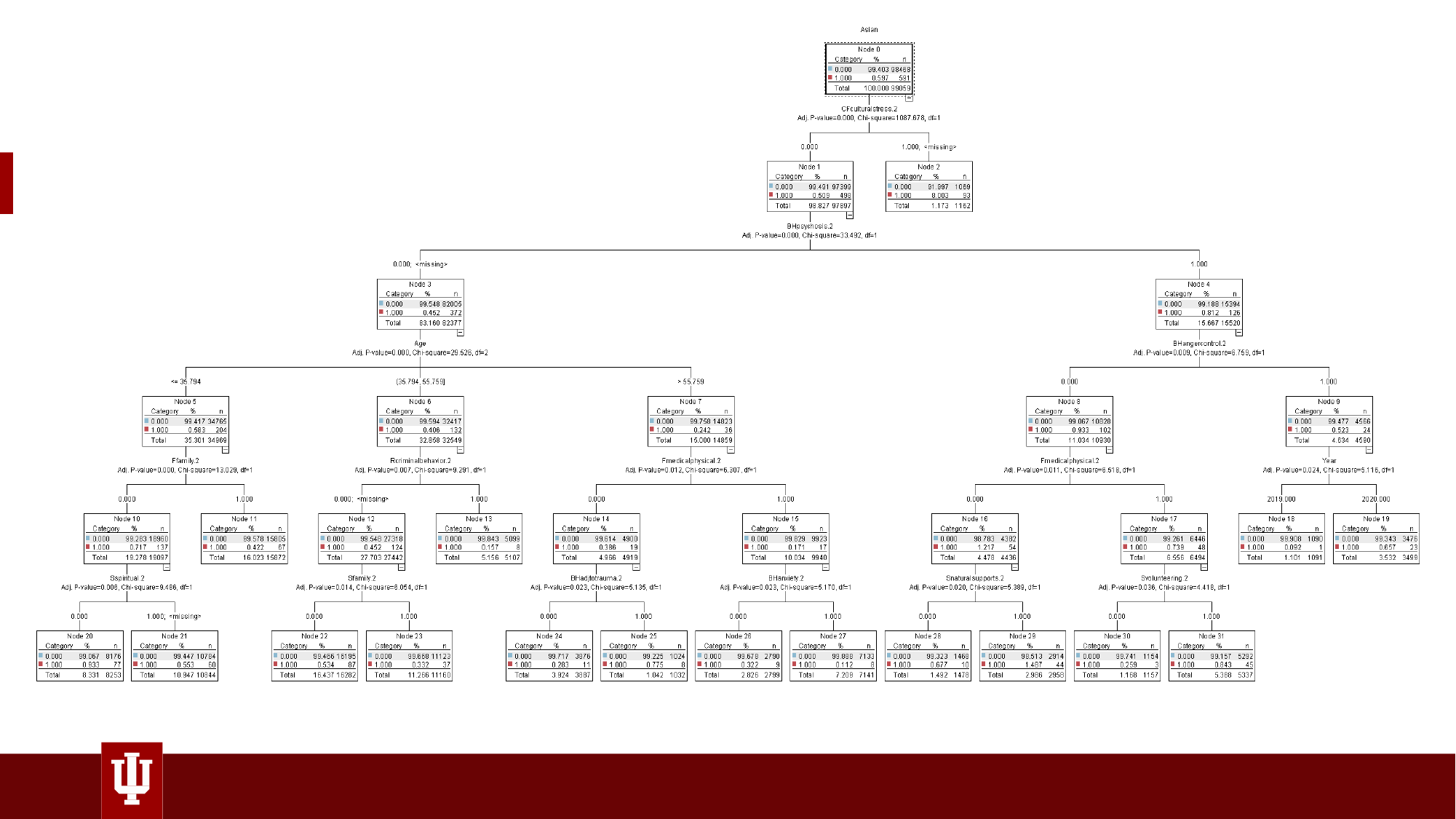
What is the total percentage shown in Node 3? 83.160 Which variable is used for the first split below Node 0? CFculturalstress.2 What percentage of Node 0 falls in category 0.000? 99.403 What is the title printed at the top of the tree? Asian What is the total n shown in Node 2? 1162 What kind of diagram is shown on the slide? decision tree What is the n for category 1.000 in Node 0? 591 How many nodes are shown in the tree? 32 What is the total n shown in Node 0? 99059 What is the total n shown in Node 4? 15520 What is the Chi-square value printed for the first split below Node 0? 1087.678 Which has the larger total n, Node 1 or Node 2? Node 1